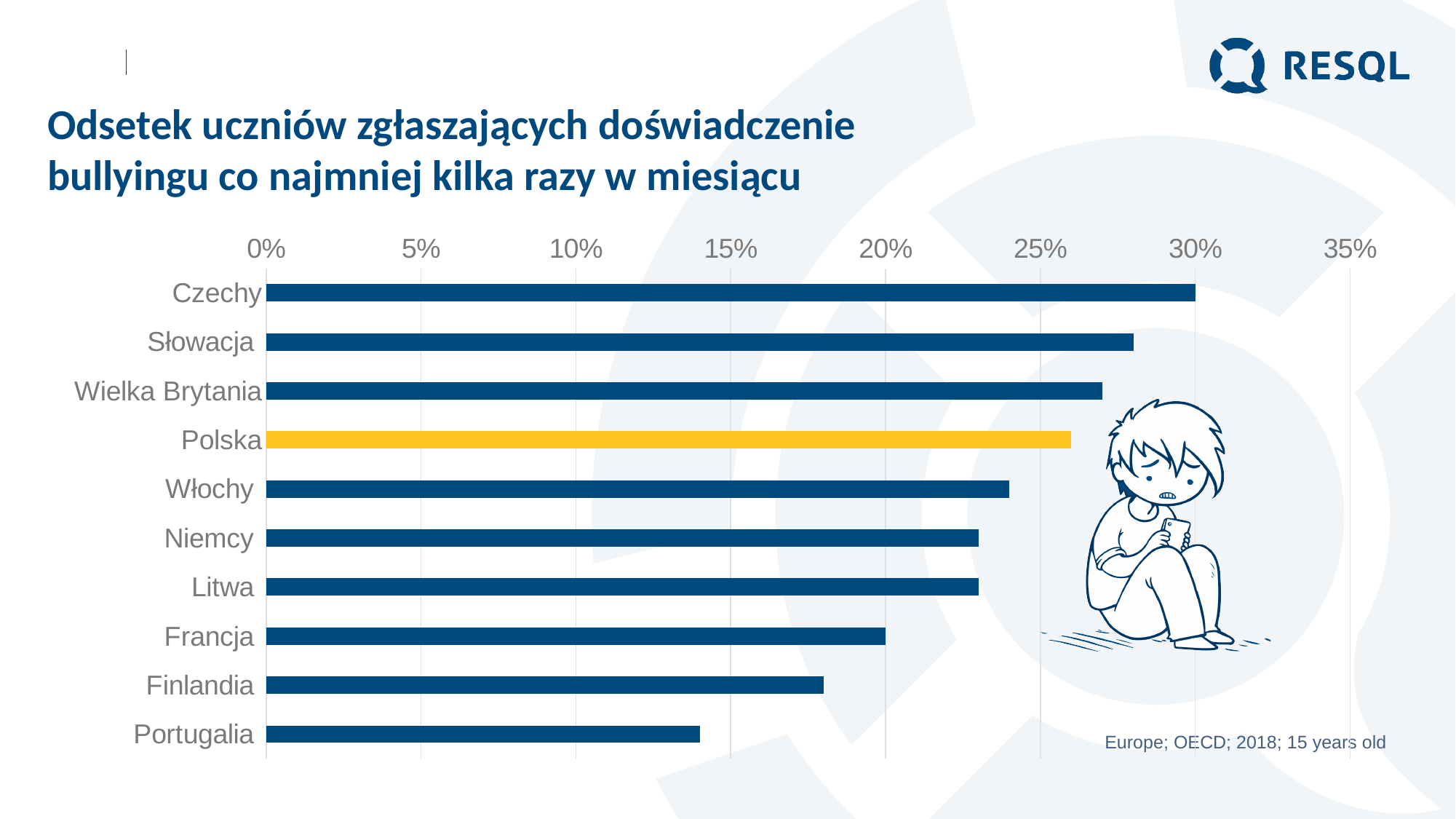
Is the value for Finlandia greater or less than 20%? less What is the value for Francja? 20% Is the value for Włochy greater or less than 25%? less Which country has the highest value in the chart? Czechy What is the value for Czechy? 30% What kind of chart is shown on the slide? bar chart Which country has the lowest value in the chart? Portugalia How many countries are shown in the chart? 10 Is the value for Portugalia greater or less than 15%? less Which has a larger value, Polska or Włochy? Polska Which country's bar is highlighted in yellow? Polska